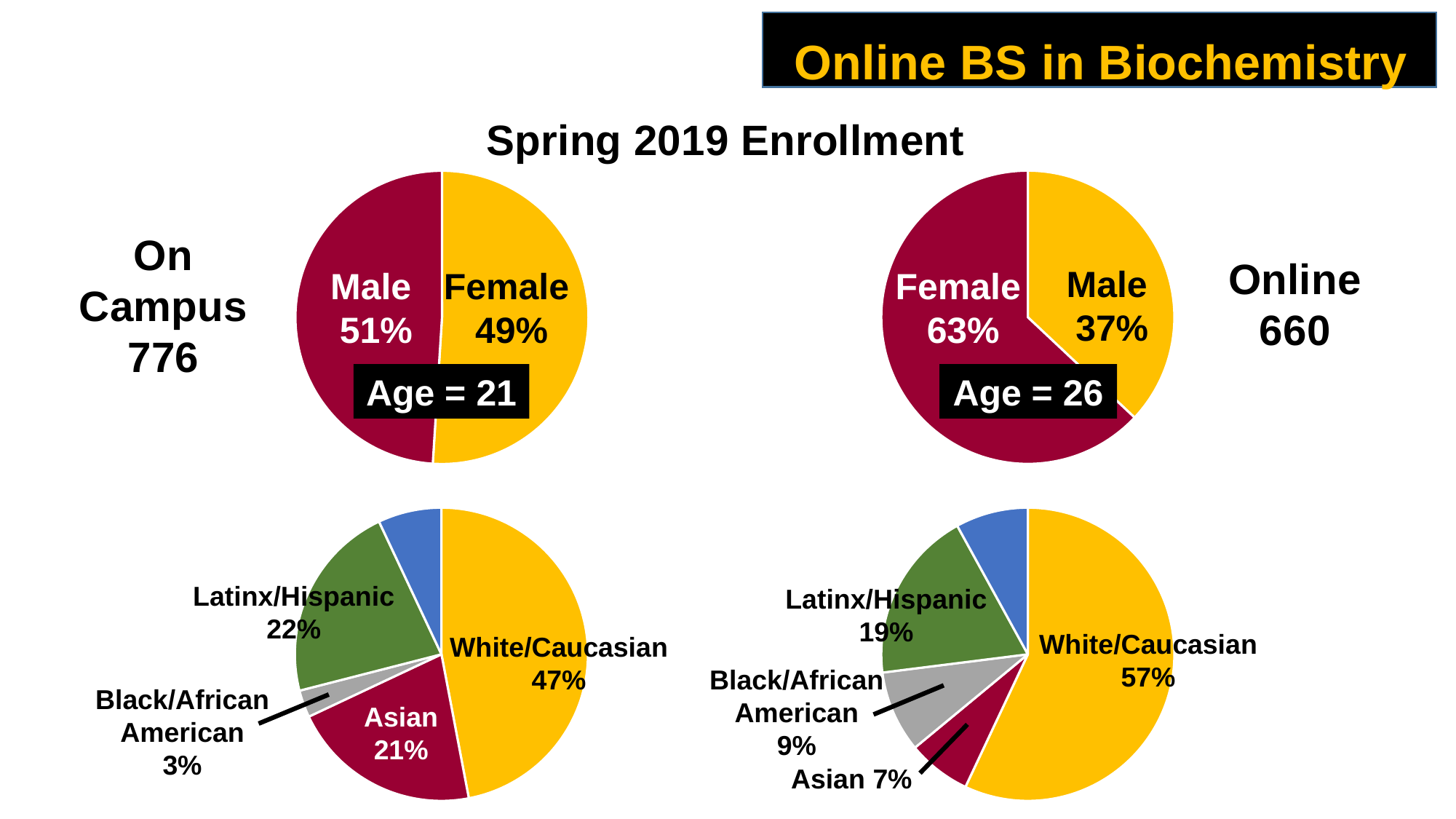
In the Online gender pie chart, what percentage of students are male? 37% In the Online gender pie chart, what percentage of students are female? 63% In the Online ethnicity pie chart, what share is Black/African American? 9% What is the difference between the Female share in the Online gender pie chart and the Female share in the On Campus gender pie chart? 14% In the Online ethnicity pie chart, which group has the largest share? White/Caucasian In the On Campus gender pie chart, what percentage of students are male? 51% What is the average age shown for the Online students? 26 Which is larger: the Asian share in the On Campus ethnicity pie chart or the Asian share in the Online ethnicity pie chart? On Campus In the Online ethnicity pie chart, what share is Latinx/Hispanic? 19% In the On Campus ethnicity pie chart, what share is White/Caucasian? 47% What type of chart is used to show the Spring 2019 Enrollment data on this slide? Pie chart In the On Campus ethnicity pie chart, which labeled group has the smallest share? Black/African American